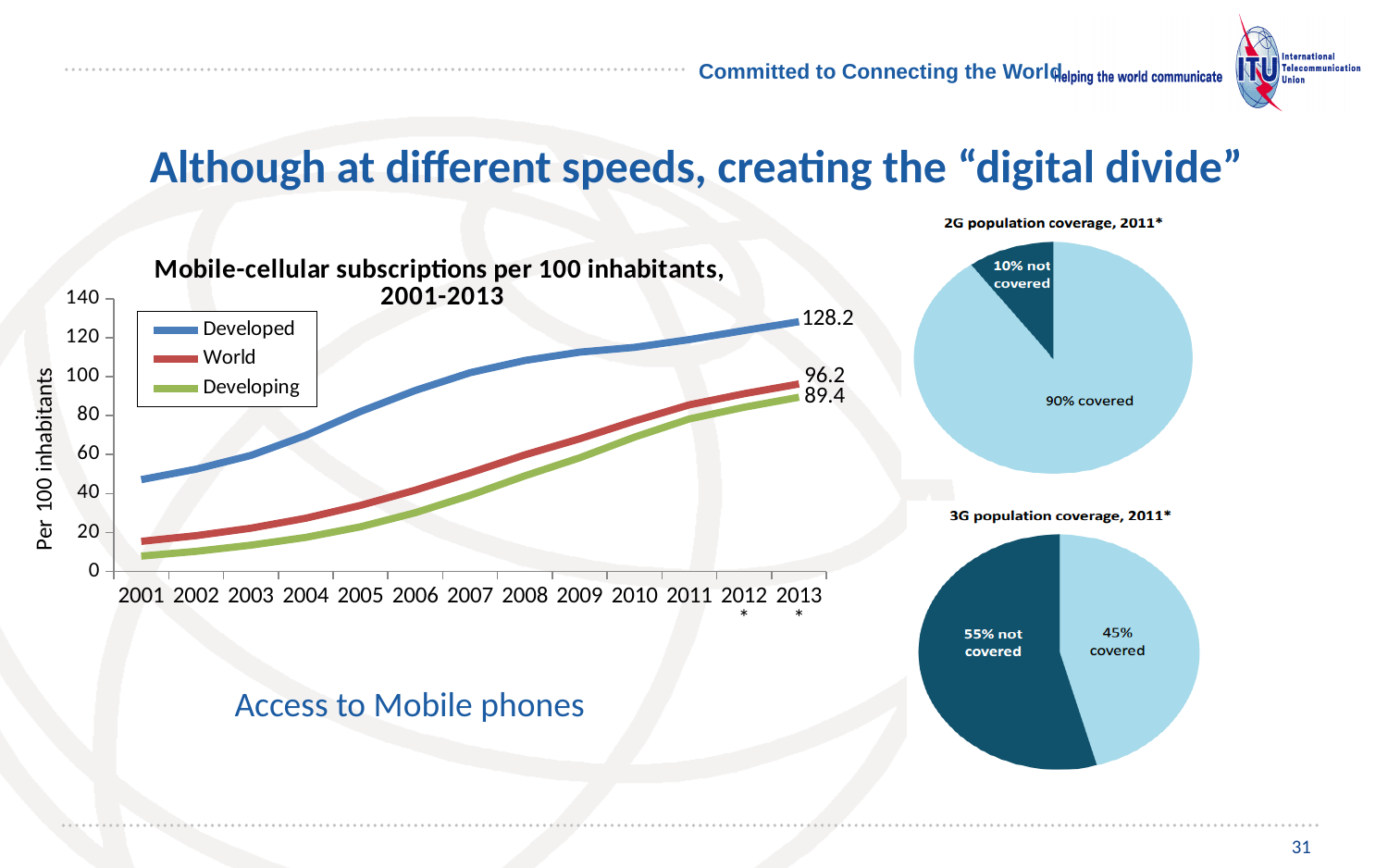
In the 'Mobile-cellular subscriptions per 100 inhabitants, 2001-2013' chart, what is the value for Developed in 2013? 128.2 In the 'Mobile-cellular subscriptions per 100 inhabitants, 2001-2013' chart, what is the value for World in 2013? 96.2 In the '2G population coverage, 2011*' pie chart, what share of the population is covered? 90% covered In the 'Mobile-cellular subscriptions per 100 inhabitants, 2001-2013' chart, what is the difference between the Developed and Developing values in 2013? 38.8 In the 'Mobile-cellular subscriptions per 100 inhabitants, 2001-2013' chart, how many series does the legend list? 3 In the 'Mobile-cellular subscriptions per 100 inhabitants, 2001-2013' chart, which series has the highest value in 2013? Developed In the 'Mobile-cellular subscriptions per 100 inhabitants, 2001-2013' chart, how many years are shown on the x axis? 13 In the 'Mobile-cellular subscriptions per 100 inhabitants, 2001-2013' chart, does the Developing series rise or fall from 2001 to 2013? Rise In the 'Mobile-cellular subscriptions per 100 inhabitants, 2001-2013' chart, is the value for Developed in 2001 greater or less than 40? greater In the '3G population coverage, 2011*' pie chart, what share of the population is not covered? 55% not covered In the 'Mobile-cellular subscriptions per 100 inhabitants, 2001-2013' chart, what is the value for Developing in 2013? 89.4 What kind of chart is 'Mobile-cellular subscriptions per 100 inhabitants, 2001-2013'? Line chart